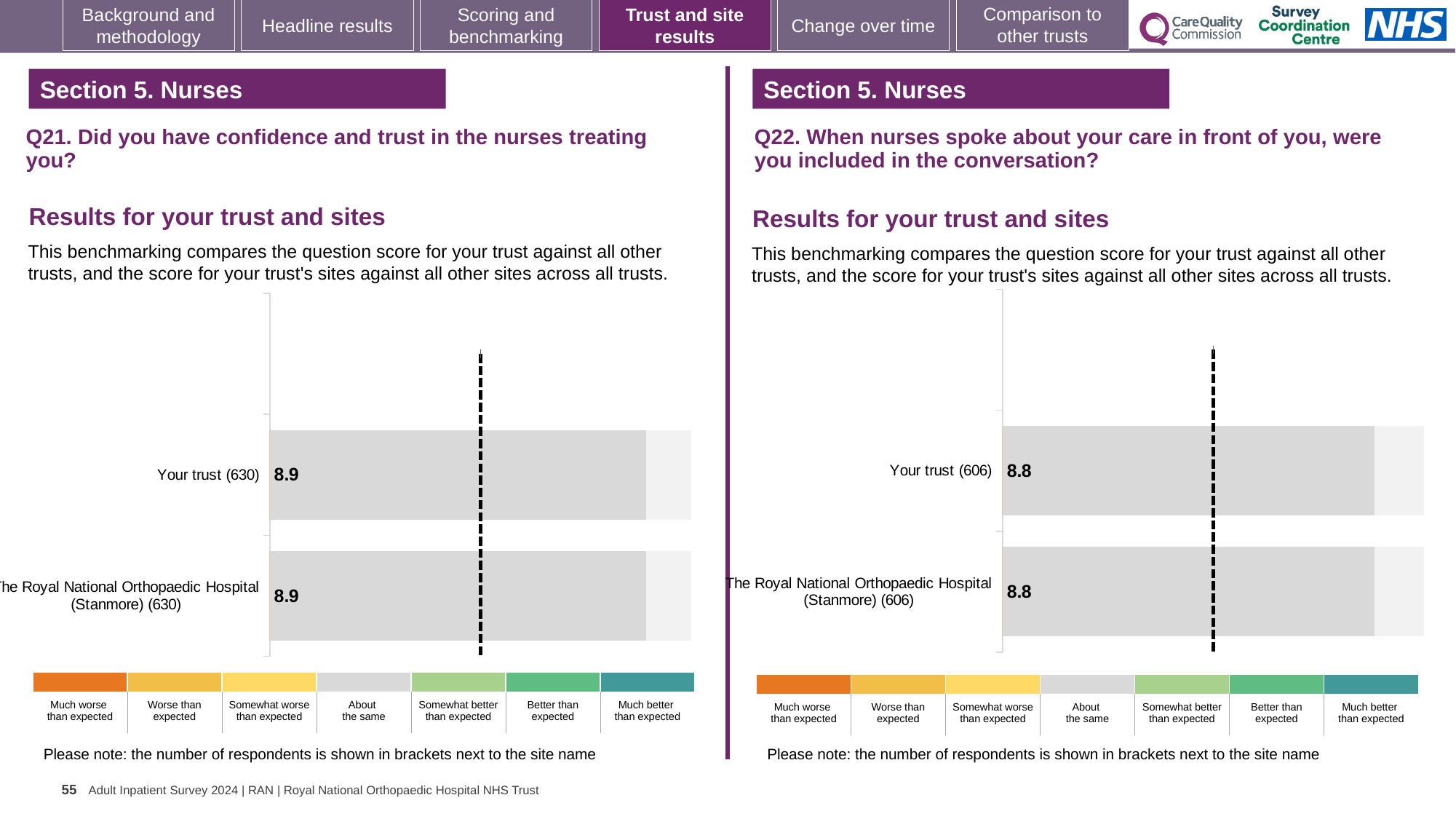
In the Q22 chart on the right, what is the difference between the score for Your trust and the score for The Royal National Orthopaedic Hospital (Stanmore)? 0 In the Q22 chart on the right, what is the score for Your trust? 8.8 In the Q22 chart on the right, what is the score for The Royal National Orthopaedic Hospital (Stanmore)? 8.8 What kind of chart is the Q21 chart on the left? Bar chart In the Q21 chart on the left, what is the score for Your trust? 8.9 In the Q22 chart on the right, how many respondents are shown in brackets for The Royal National Orthopaedic Hospital (Stanmore)? 606 How many bars are plotted in the Q21 chart on the left? 2 In the Q21 chart on the left, what is the score for The Royal National Orthopaedic Hospital (Stanmore)? 8.9 In the Q21 chart on the left, what is the difference between the score for Your trust and the score for The Royal National Orthopaedic Hospital (Stanmore)? 0 In the Q21 chart on the left, how many respondents are shown in brackets for Your trust? 630 How many bars are plotted in the Q22 chart on the right? 2